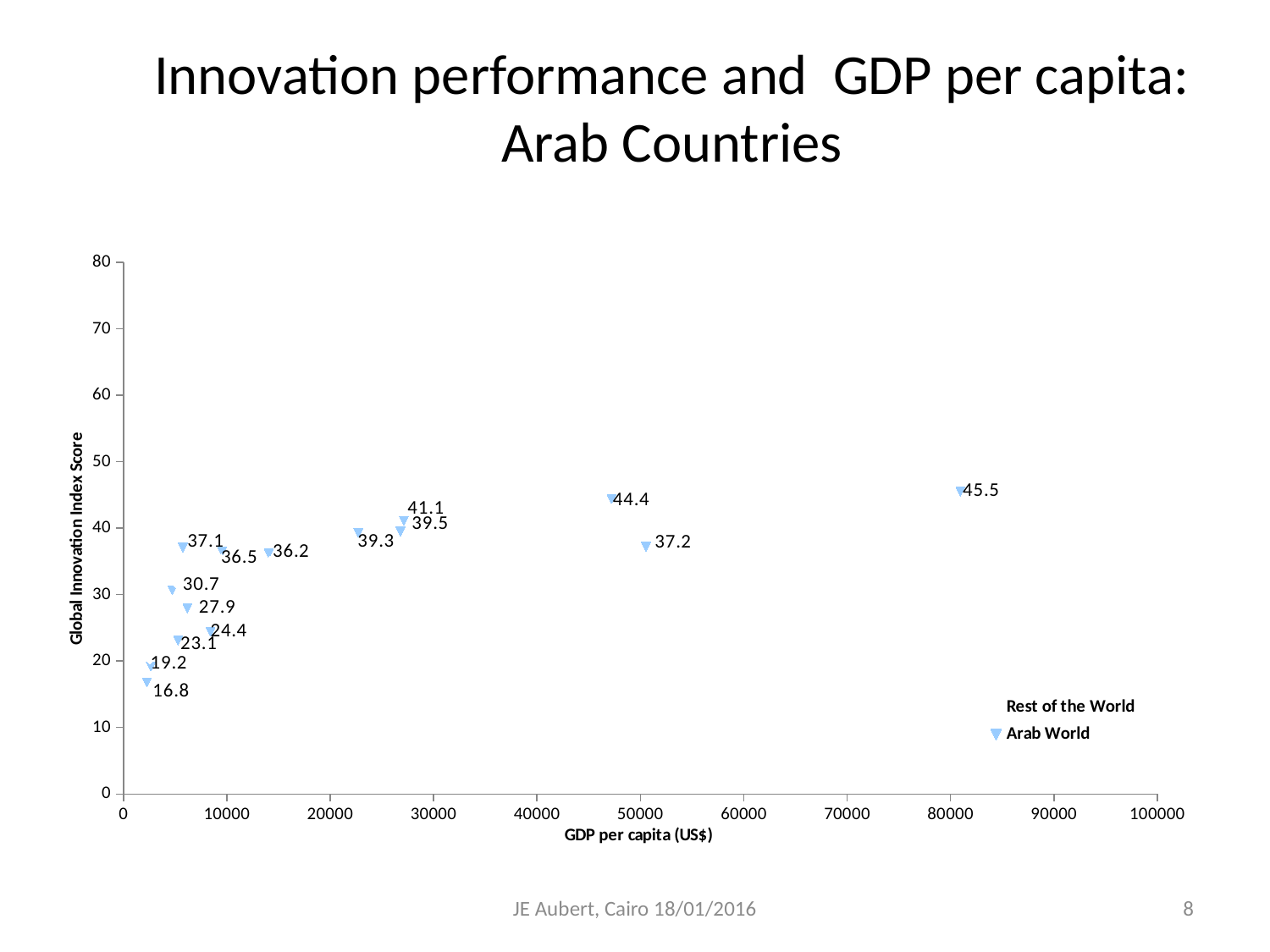
What is the lowest Global Innovation Index Score labelled on the chart? 16.8 What is the Global Innovation Index Score of the point with the highest GDP per capita? 45.5 Is the GDP per capita of the point scoring 45.5 greater or less than 80000? greater What is the difference between the highest labelled score (45.5) and the lowest labelled score (16.8)? 28.7 What kind of chart is shown on the slide? scatter chart How many series does the legend list? 2 What is the highest Global Innovation Index Score labelled on the chart? 45.5 What is the title of the x axis? GDP per capita (US$) Which is larger, the score of the point near 80000 GDP per capita or the score of the point labelled 37.2? the point near 80000 (45.5) How many labelled data points are plotted on the chart? 15 What are the two series named in the legend? Rest of the World and Arab World Is the GDP per capita of the point scoring 44.4 greater or less than 50000? less